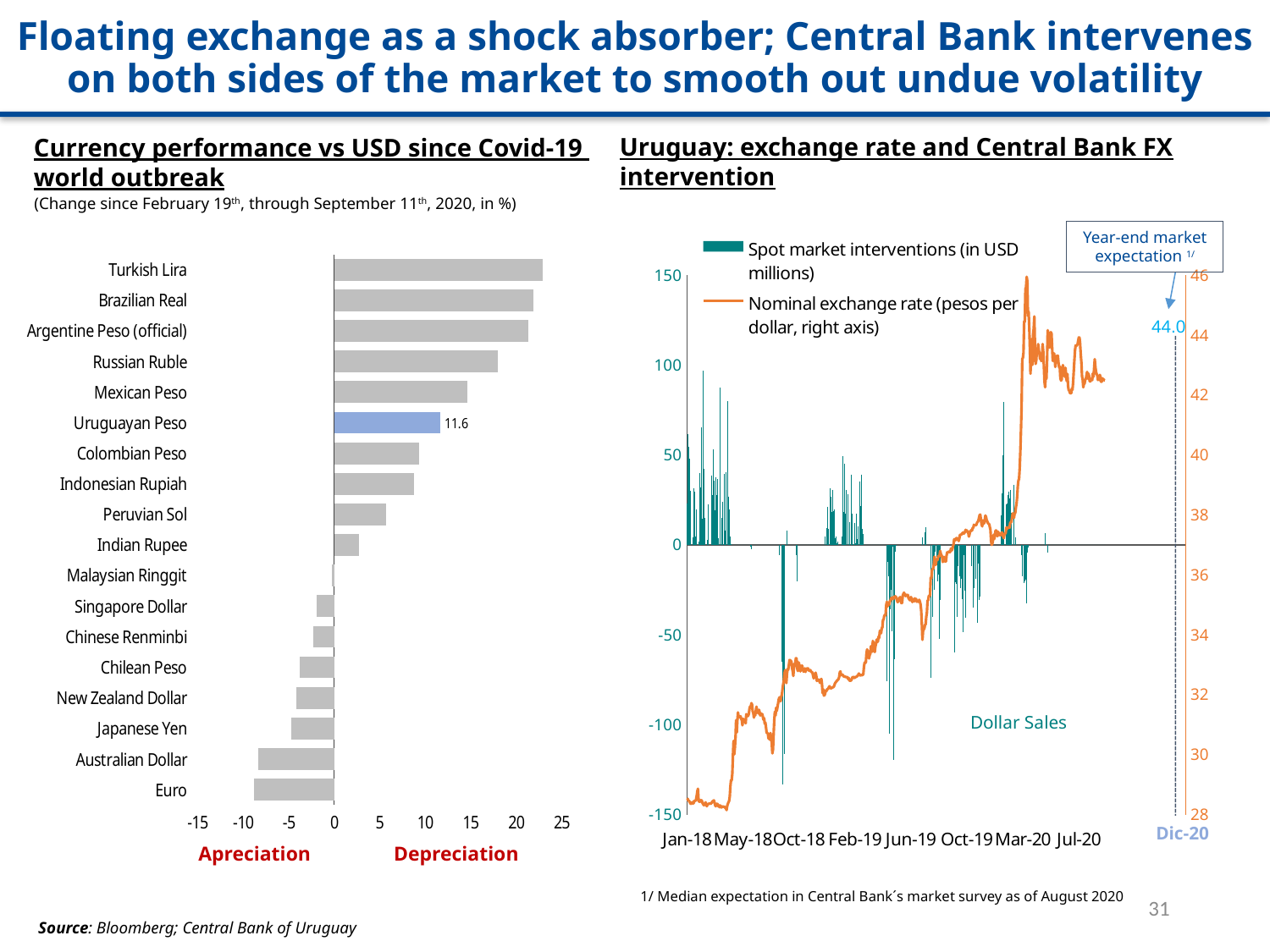
In the 'Currency performance vs USD since Covid-19 world outbreak' chart, which currency's bar is highlighted in blue? Uruguayan Peso How many series does the legend list in the 'Uruguay: exchange rate and Central Bank FX intervention' chart? 2 In the 'Currency performance vs USD since Covid-19 world outbreak' chart, which is larger, the value for the Russian Ruble or the Mexican Peso? Russian Ruble In the 'Currency performance vs USD since Covid-19 world outbreak' chart, which currency has the highest value? Turkish Lira In the 'Currency performance vs USD since Covid-19 world outbreak' chart, what is the value shown for the Uruguayan Peso? 11.6 What kind of chart is the 'Currency performance vs USD since Covid-19 world outbreak' chart? Bar chart How many currencies are listed in the 'Currency performance vs USD since Covid-19 world outbreak' chart? 18 In the 'Currency performance vs USD since Covid-19 world outbreak' chart, is the value for the Euro greater or less than -5? less In the 'Currency performance vs USD since Covid-19 world outbreak' chart, is the value for the Indian Rupee greater or less than 5? less In the 'Uruguay: exchange rate and Central Bank FX intervention' chart, what is the year-end market expectation for the exchange rate? 44.0 In the 'Currency performance vs USD since Covid-19 world outbreak' chart, is the value for the Turkish Lira greater or less than 20? greater In the 'Uruguay: exchange rate and Central Bank FX intervention' chart, does the nominal exchange rate generally rise or fall from Jan-18 to Jul-20? rise